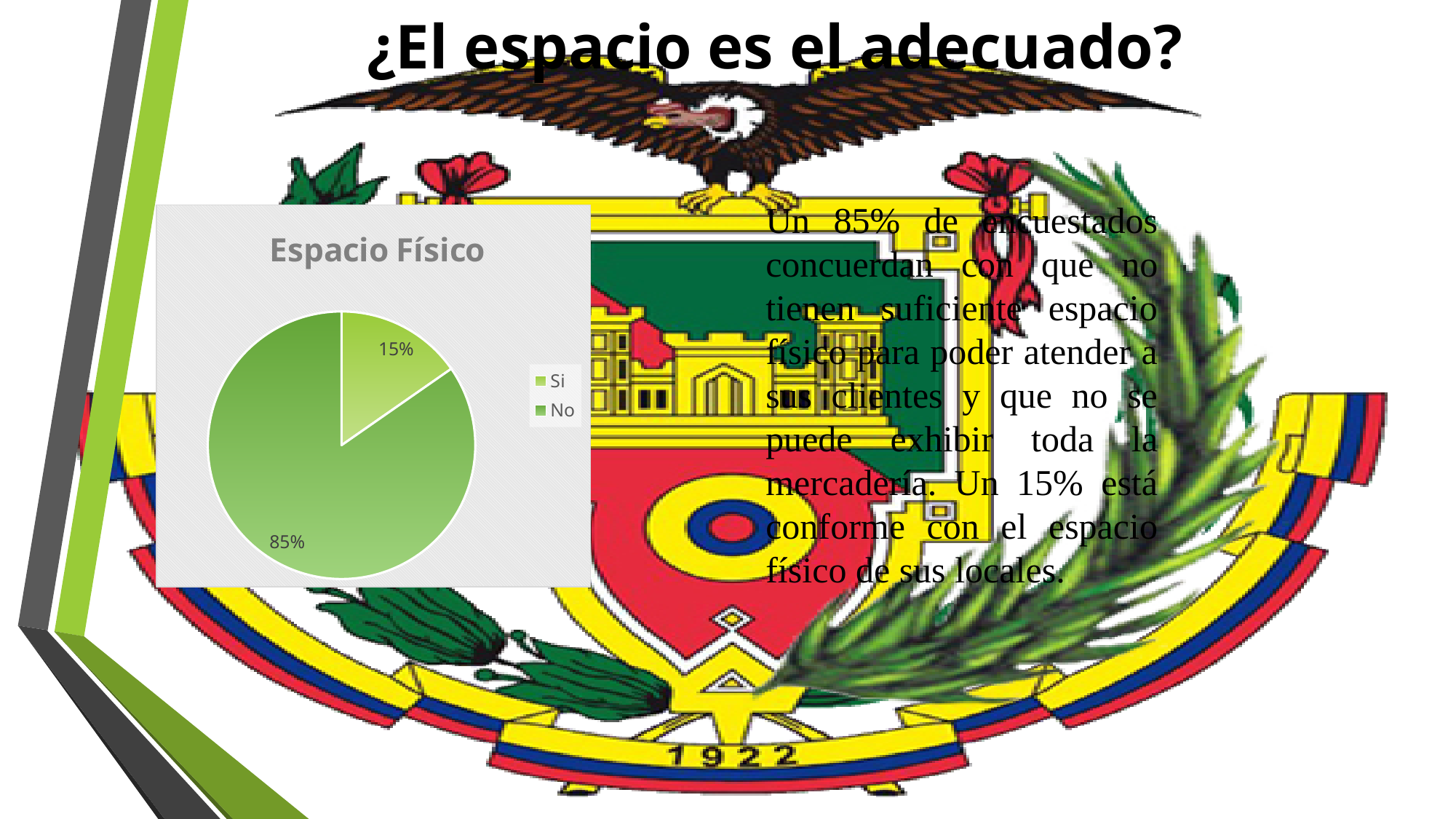
What share of the pie does "Si" represent? 15% Which category has the smallest slice of the pie? Si Is the value for "No" greater or less than 50%? greater What share of the pie does "No" represent? 85% What is the title of the chart? Espacio Físico What is the difference in percentage points between the "No" and "Si" slices? 70 What kind of chart is shown on the slide? pie chart How many categories does the pie chart have? 2 How many entries does the legend list? 2 Which is larger, the "Si" slice or the "No" slice? No What are the two legend entries of the chart? Si, No Which category has the largest slice of the pie? No